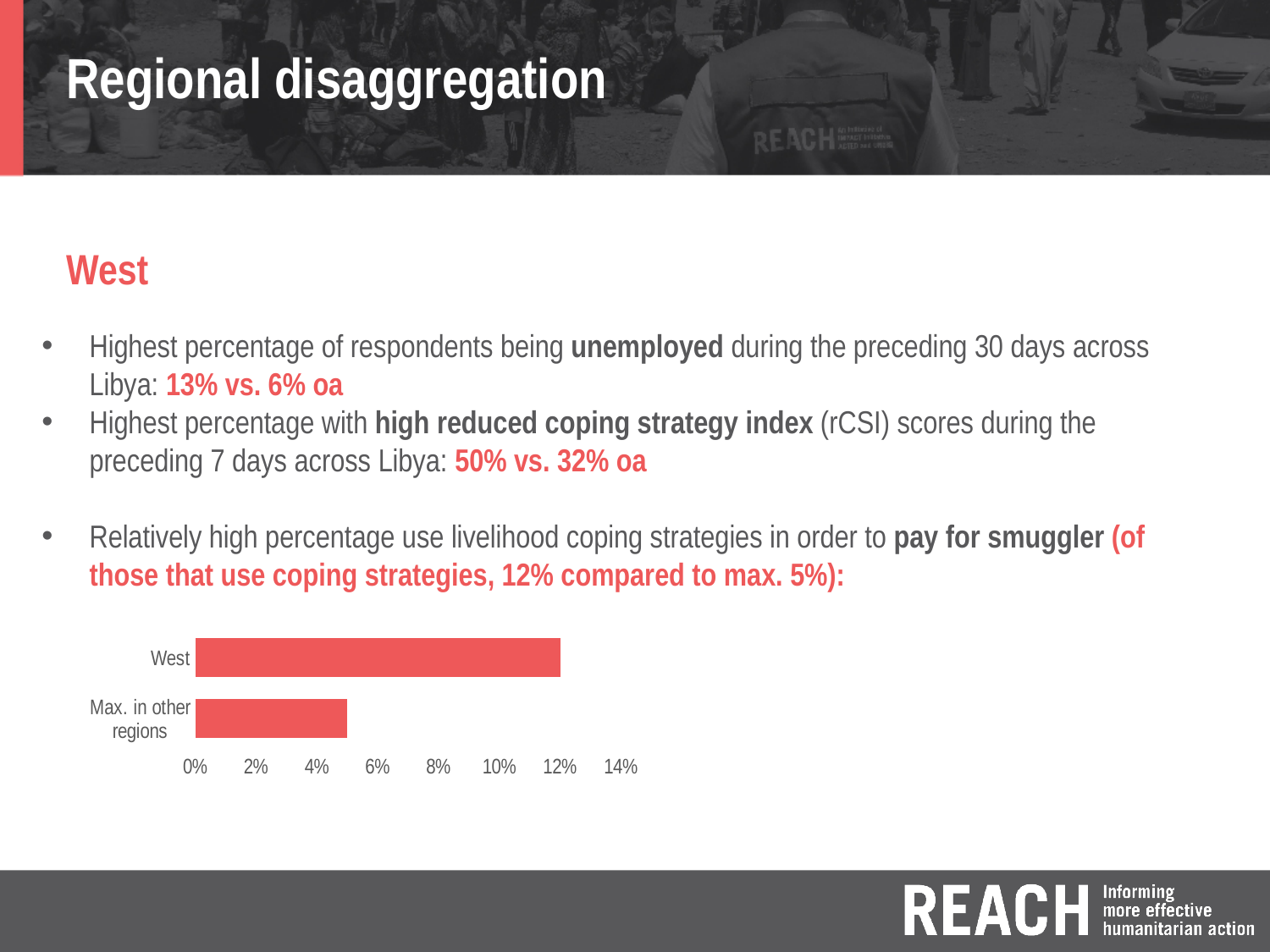
Is the value for Max. in other regions greater or less than 6%? less Is the value for West greater or less than 10%? greater Which is larger, the value for West or the value for Max. in other regions? West Which category has the highest value in the chart? West Which category has the lowest value in the chart? Max. in other regions Is the value for Max. in other regions greater or less than 4%? greater Are the bars in the chart horizontal or vertical? Horizontal What colour are the bars in the chart? Red What kind of chart is shown on the slide? Bar chart How many categories are plotted in the chart? 2 What is the value for West in the chart? 12% What is the highest tick label shown on the chart's value axis? 14%